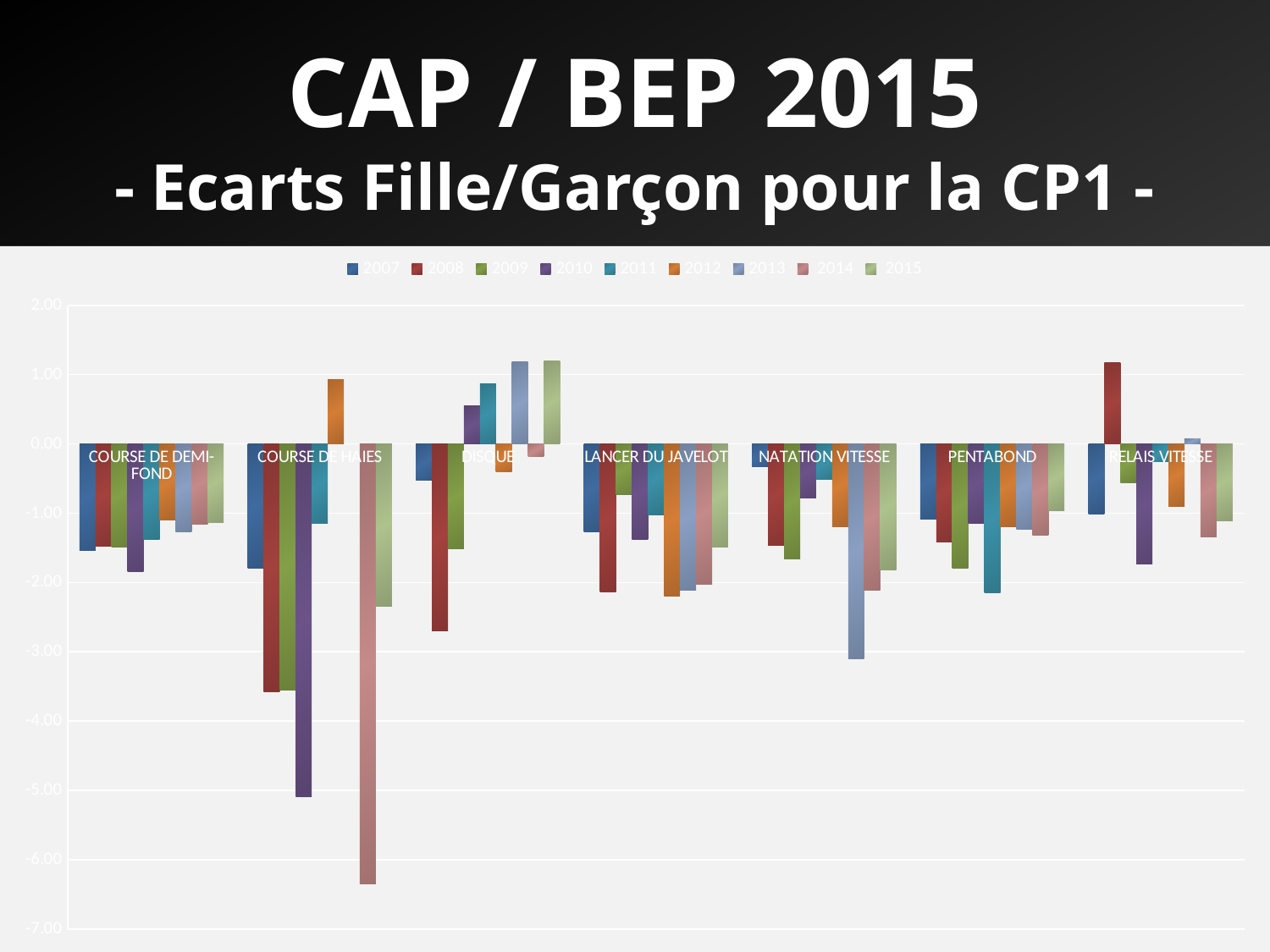
How many series does the chart legend list? 9 What kind of chart is shown on the slide? bar chart Is the value for 2008 in RELAIS VITESSE greater or less than 1.00? greater Within COURSE DE HAIES, which series has the lowest value? 2014 Is the value for 2008 in DISQUE greater or less than -2.00? less Which years are listed in the chart legend? 2007 to 2015 How many categories (events) are shown along the x axis of the chart? 7 Is the value for 2014 in COURSE DE HAIES greater or less than -6.00? less Which is larger, the value for 2012 in COURSE DE HAIES or the value for 2010 in COURSE DE HAIES? 2012 Which category contains the lowest bar in the chart? COURSE DE HAIES